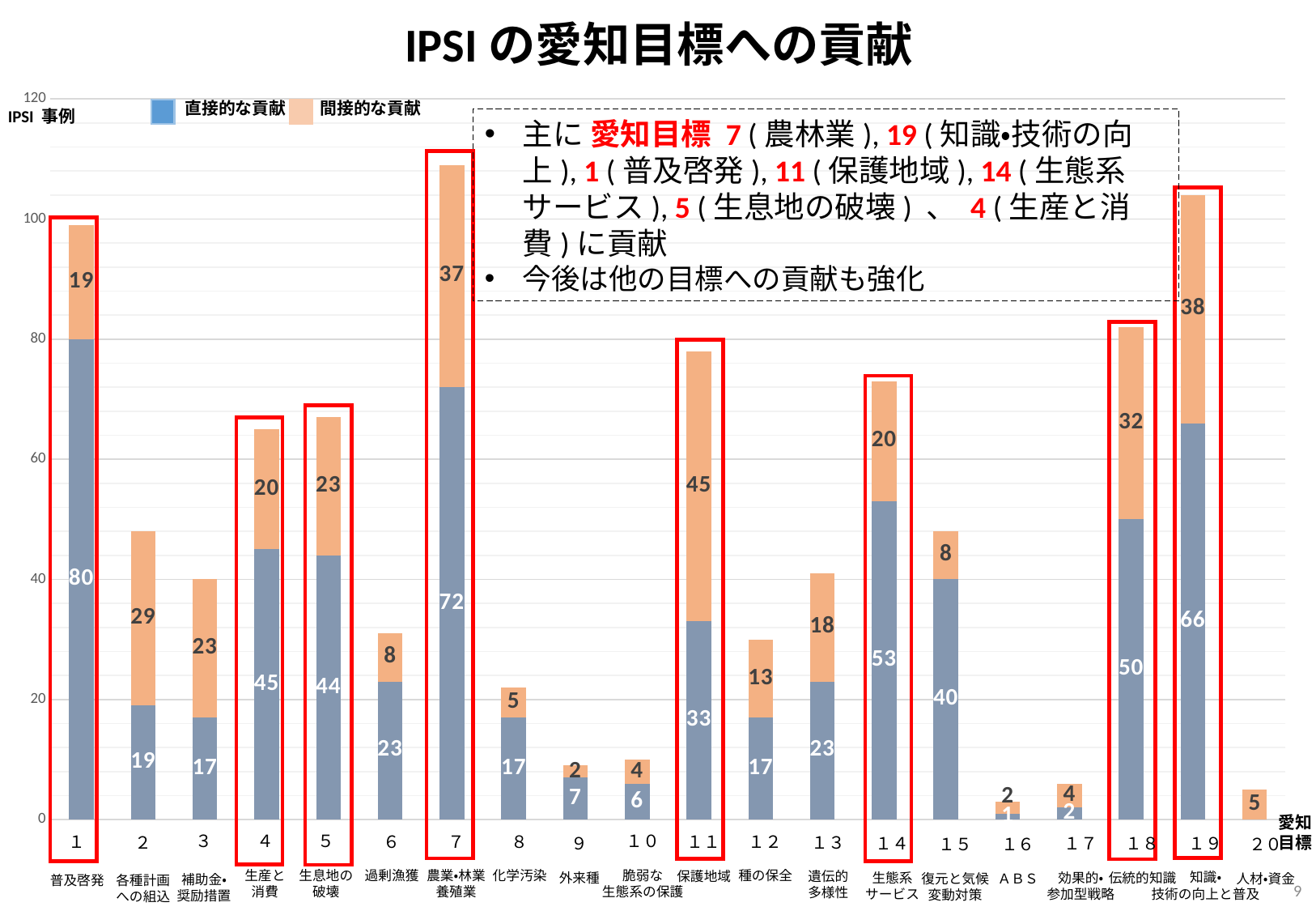
Which target has the lowest total stacked bar? 16 (ABS) What kind of chart is shown on the slide? stacked bar chart What is the value of 間接的な貢献 for target 11 (保護地域)? 45 Which target has the highest value of 直接的な貢献? 1 (普及啓発) What is the value of 直接的な貢献 for target 7 (農業•林業養殖業)? 72 How many series does the legend list? 2 What is the difference between the 直接的な貢献 values for target 1 and target 19? 14 How many categories (Aichi targets) are plotted along the x axis? 20 Is the total stacked bar for target 7 greater or less than 100? greater What is the total of the stacked bar for target 18 (伝統的知識)? 82 Which is larger for target 11: 直接的な貢献 or 間接的な貢献? 間接的な貢献 What is the value of 直接的な貢献 for target 19 (知識•技術の向上と普及)? 66